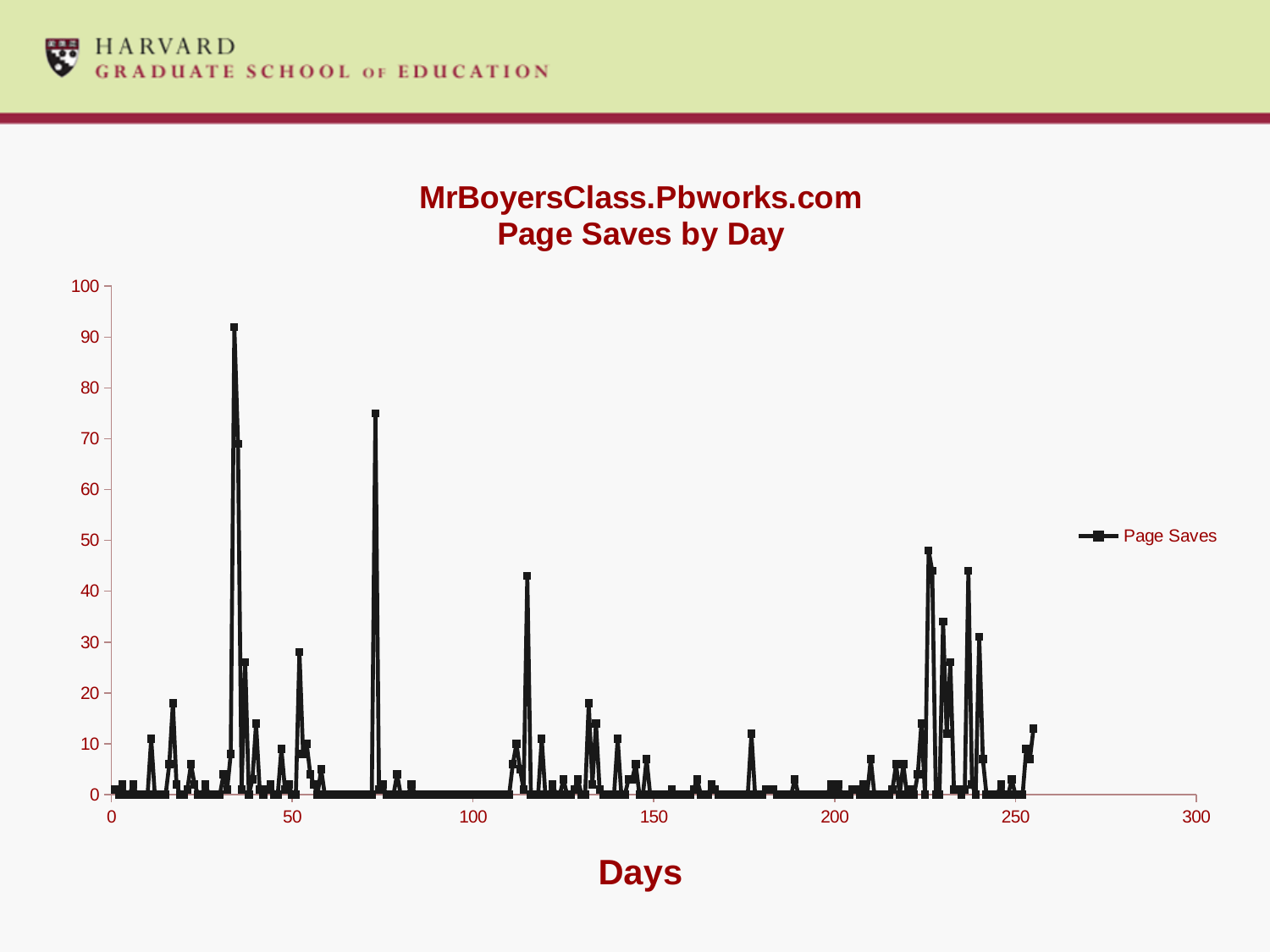
Is the highest peak of the Page Saves line greater or less than 80? greater Is the peak of Page Saves that occurs between day 100 and day 150 greater or less than 30? greater What kind of chart is shown on the slide? line chart What is the name of the series shown in the legend? Page Saves How many series does the legend list? 1 What is the label of the x axis? Days Is the value of Page Saves at day 100 greater or less than 10? less What is the maximum value shown on the y axis? 100 Which is larger: the peak of Page Saves just before day 50 or the peak between day 50 and day 100? the peak just before day 50 Is the highest peak of Page Saves located before or after day 50 on the x axis? before